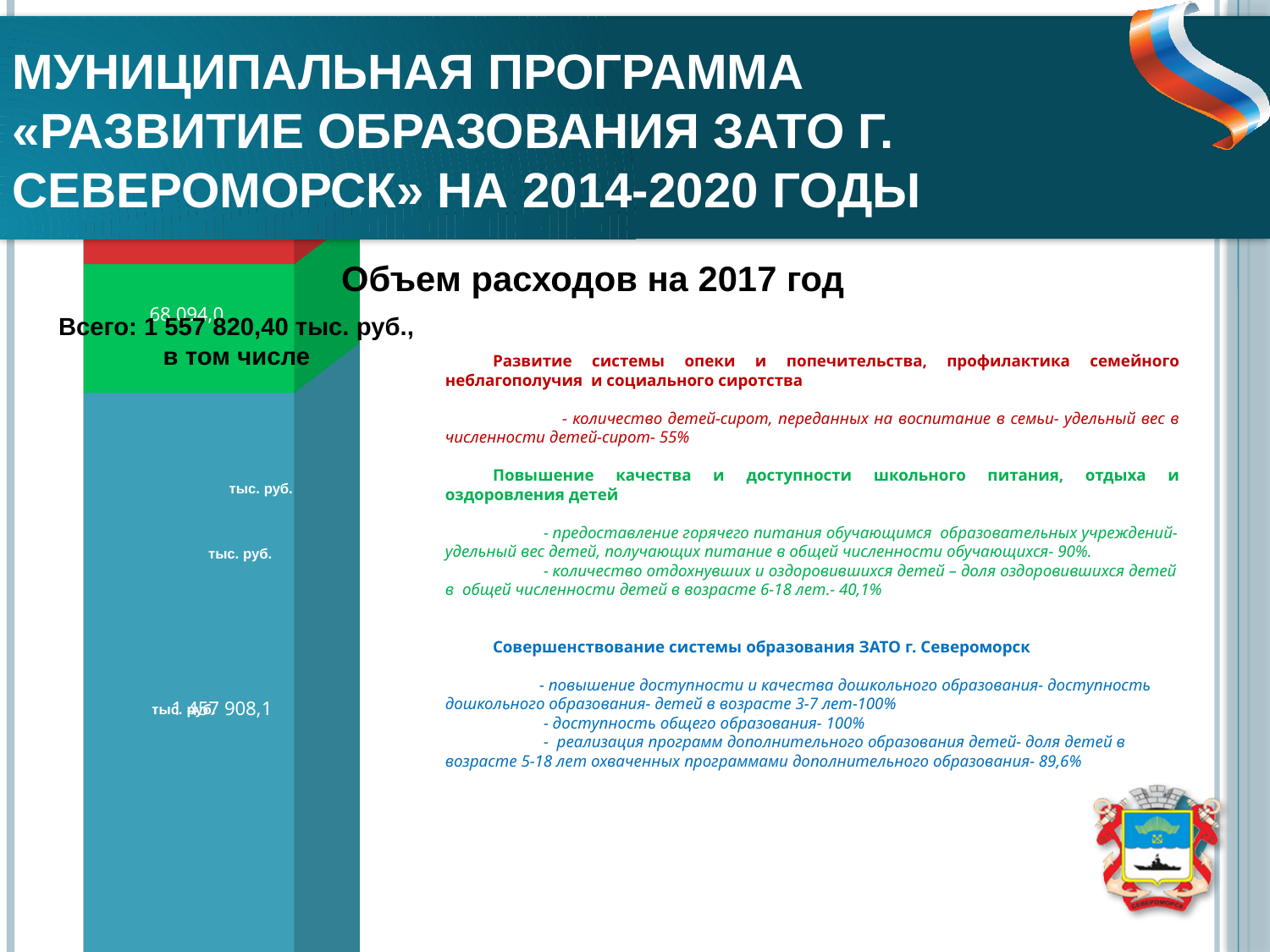
Which is larger, the blue segment or the green segment of the stacked bar? the blue segment How many segments make up the stacked bar on the left of the slide? 3 What kind of chart is shown on the left of the slide? stacked bar chart What value is printed on the blue segment of the stacked bar? 1 457 908,1 What is the difference between the blue segment value and the green segment value in the stacked bar? 1 389 814,1 What total amount is stated above the chart for 2017 (Всего)? 1 557 820,40 тыс. руб. Which segment of the stacked bar is the largest? the blue segment What is the title of the chart section on the slide? Объем расходов на 2017 год What value is printed on the green segment of the stacked bar? 68 094,0 Which segment of the stacked bar is the smallest? the red segment